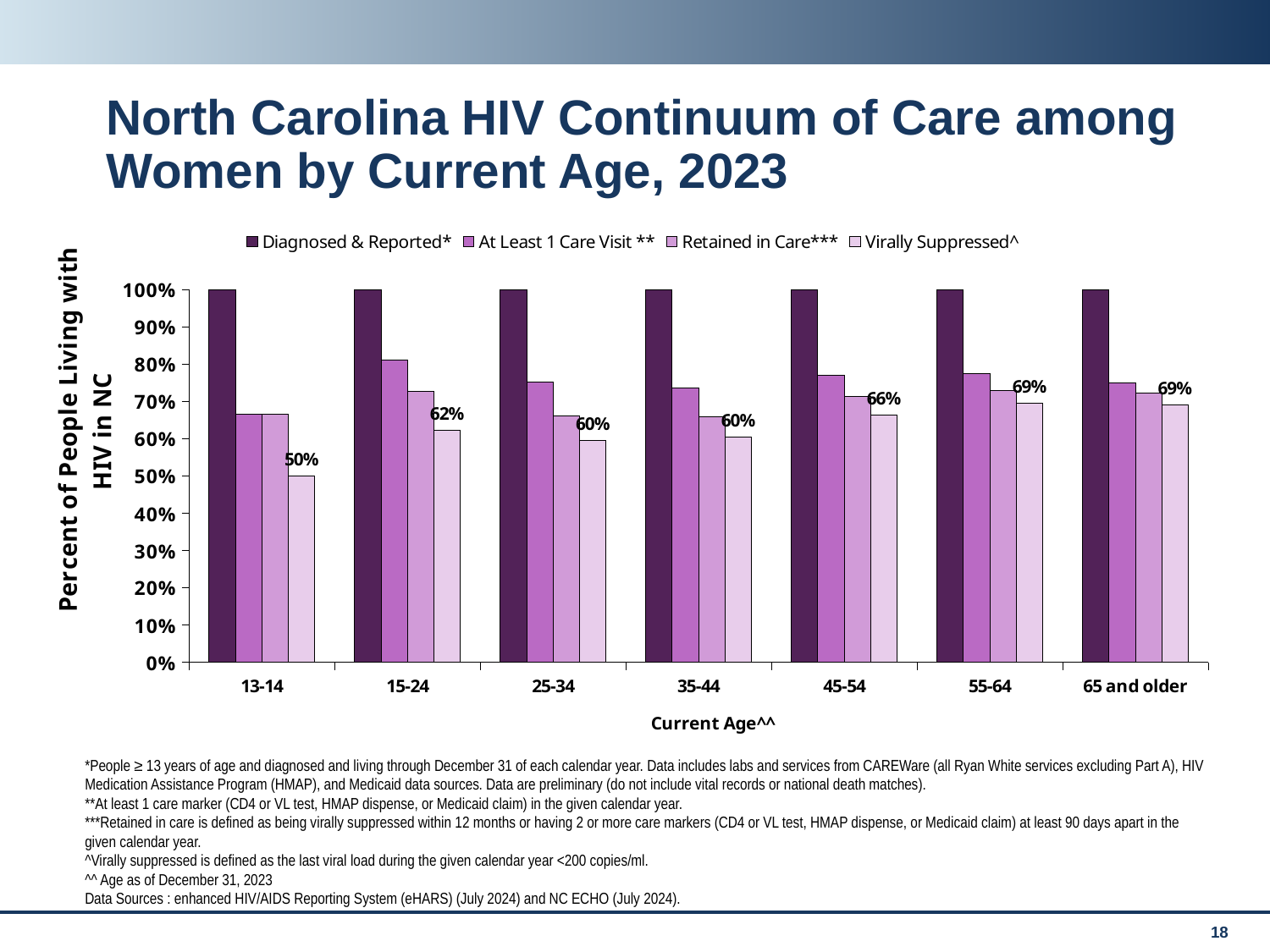
What is the Virally Suppressed^ value for the 13-14 age group? 50% What is the Virally Suppressed^ value for the 45-54 age group? 66% Which age group has a higher Virally Suppressed^ value, 15-24 or 45-54? 45-54 What is the difference between the Virally Suppressed^ values for the 45-54 and 13-14 age groups? 16 percentage points What kind of chart is shown on the slide? Bar chart What is the title of the x axis? Current Age^^ Which age group has the lowest Virally Suppressed^ value? 13-14 How many age groups are shown on the x axis? 7 What is the Diagnosed & Reported* value for the 25-34 age group? 100% How many series does the legend list? 4 Is the At Least 1 Care Visit ** value for the 13-14 age group greater or less than 70%? less Is the Retained in Care*** value for the 15-24 age group greater or less than 70%? greater